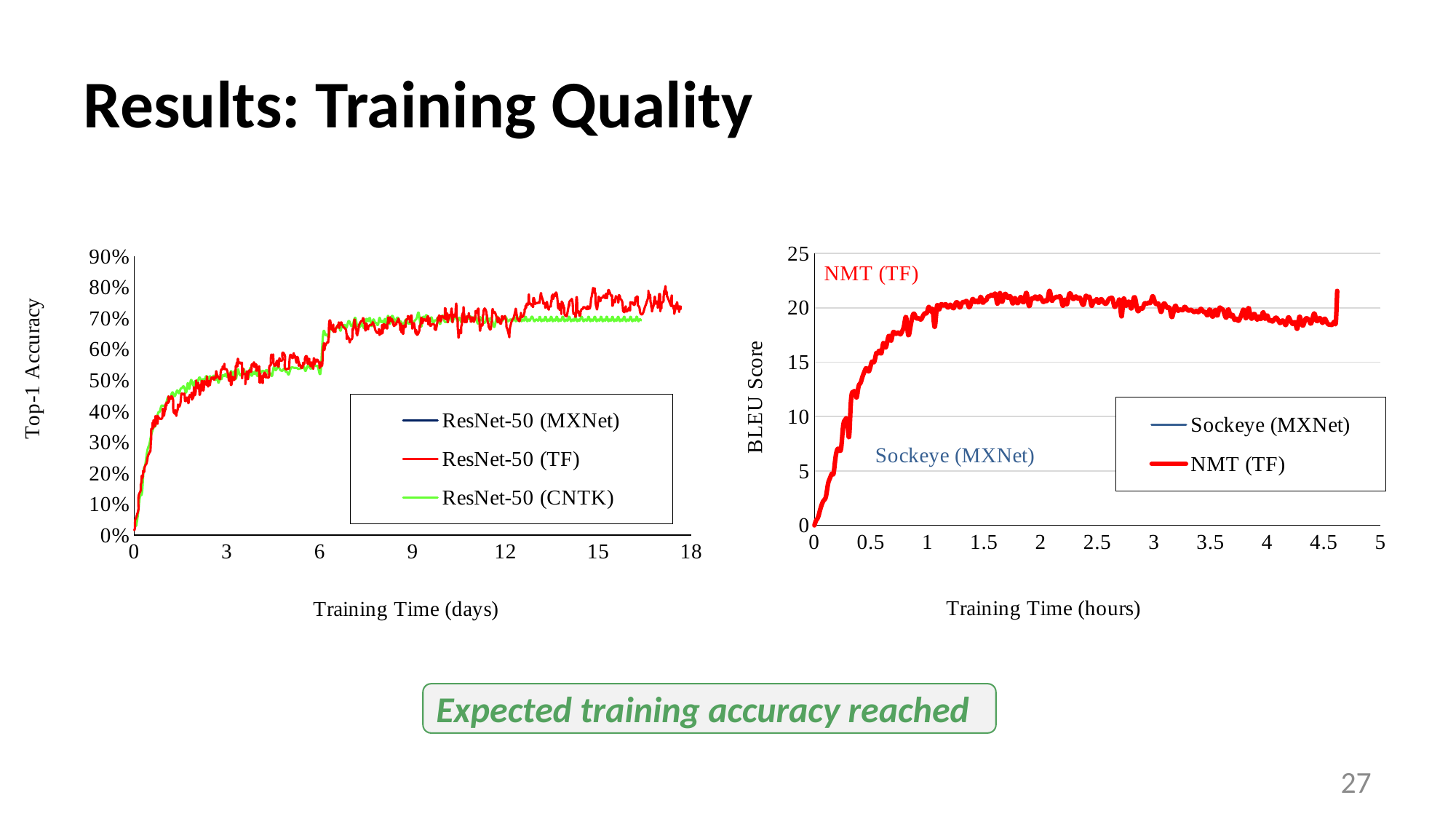
In the right chart, is the BLEU Score of NMT (TF) at 2 hours greater or less than 15? greater What is the y-axis label of the left chart? Top-1 Accuracy In the left chart, does the Top-1 Accuracy of ResNet-50 (TF) generally rise or fall as training time increases? rise How many series does the legend of the left chart (Top-1 Accuracy) list? 3 In the right chart, does the BLEU Score of NMT (TF) rise or fall between 0 and 1 hour of training time? rise What is the x-axis label of the right chart? Training Time (hours) In the left chart, is the Top-1 Accuracy of ResNet-50 (CNTK) at 3 days greater or less than 70%? less What kind of chart is the left chart (Top-1 Accuracy vs Training Time)? line chart In the left chart, is the Top-1 Accuracy of ResNet-50 (TF) at 15 days greater or less than 60%? greater How many series does the legend of the right chart (BLEU Score) list? 2 What kind of chart is the right chart (BLEU Score vs Training Time)? line chart